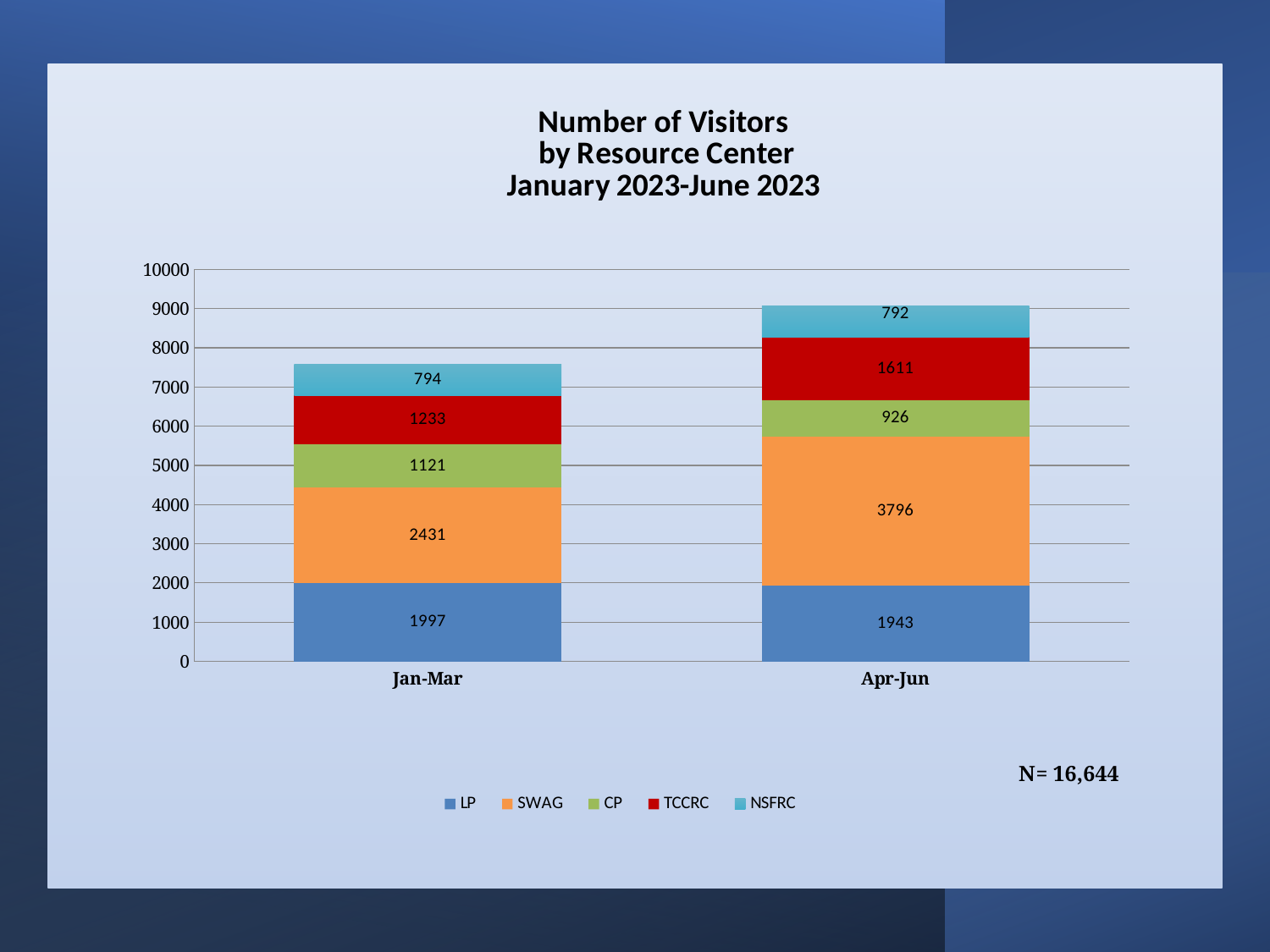
What is the difference between the SWAG values for Apr-Jun and Jan-Mar? 1365 What is the total of the stacked bar for Apr-Jun? 9068 What is the value for SWAG in Apr-Jun? 3796 Which resource center has the highest value in Apr-Jun? SWAG What is the total of the stacked bar for Jan-Mar? 7576 Which is larger, the CP value in Jan-Mar or the CP value in Apr-Jun? Jan-Mar What is the value for NSFRC in Apr-Jun? 792 What is the value for TCCRC in Jan-Mar? 1233 What kind of chart is shown on the slide? Stacked bar chart What is the N value shown on the slide? N= 16,644 How many series does the legend list? 5 Which resource center has the lowest value in Jan-Mar? NSFRC